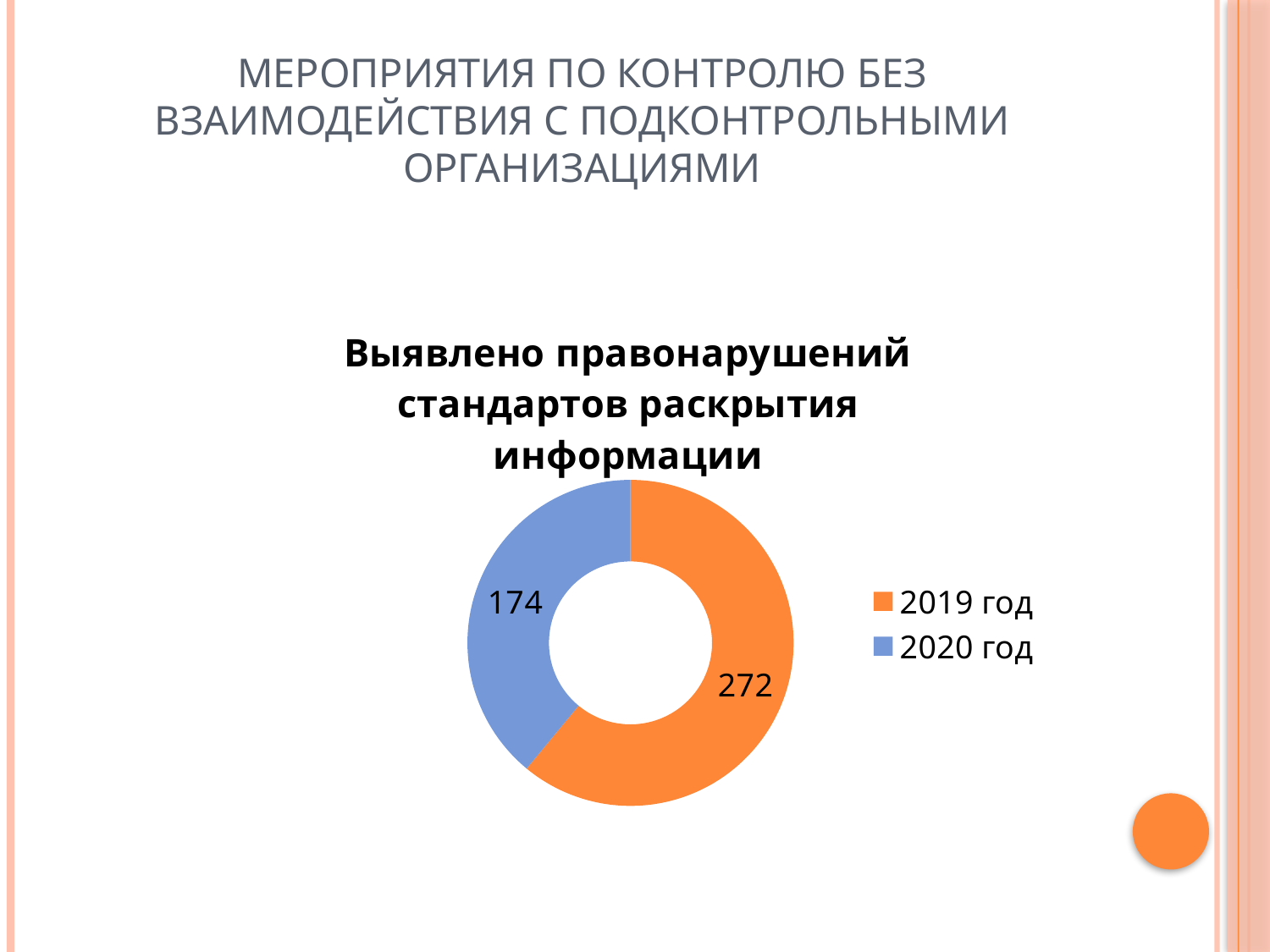
Which year has the highest value? 2019 год How many categories does the chart show? 2 What is the value for 2020 год? 174 What is the total of the two values shown in the chart? 446 What kind of chart is shown on the slide? Doughnut (pie) chart Which year has the lowest value? 2020 год What is the difference between the values for 2019 год and 2020 год? 98 Which is larger, the value for 2019 год or for 2020 год? 2019 год Which colour represents 2020 год in the chart? Blue What is the value for 2019 год? 272 What is the title of the chart? Выявлено правонарушений стандартов раскрытия информации How many entries does the legend list? 2